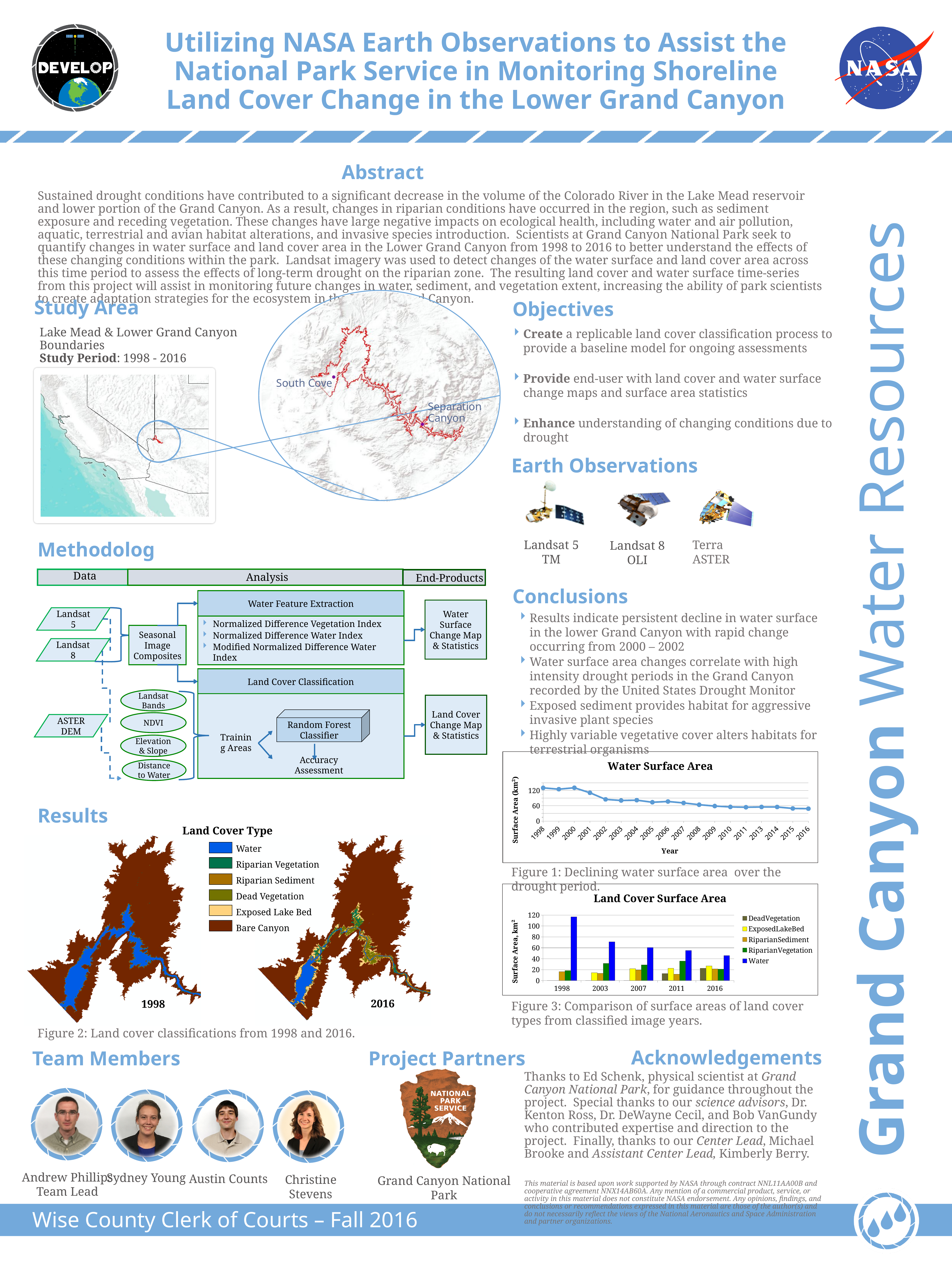
How many data points are plotted in the "Water Surface Area" chart? 18 In the "Water Surface Area" chart, is the value for 2016 greater or less than 60? less In the "Water Surface Area" chart, is the value for 2003 greater or less than 60? greater In the "Land Cover Surface Area" chart, is the Water value for 1998 greater or less than 100? greater What kind of chart is the "Land Cover Surface Area" chart? bar chart What is the y-axis title of the "Water Surface Area" chart? Surface Area (km²) How many series does the legend of the "Land Cover Surface Area" chart list? 5 In the "Water Surface Area" chart, do the values rise or fall from 1998 to 2016? fall In the "Land Cover Surface Area" chart, which year has the highest Water bar? 1998 How many years are shown on the x axis of the "Land Cover Surface Area" chart? 5 What kind of chart is the "Water Surface Area" chart? line chart